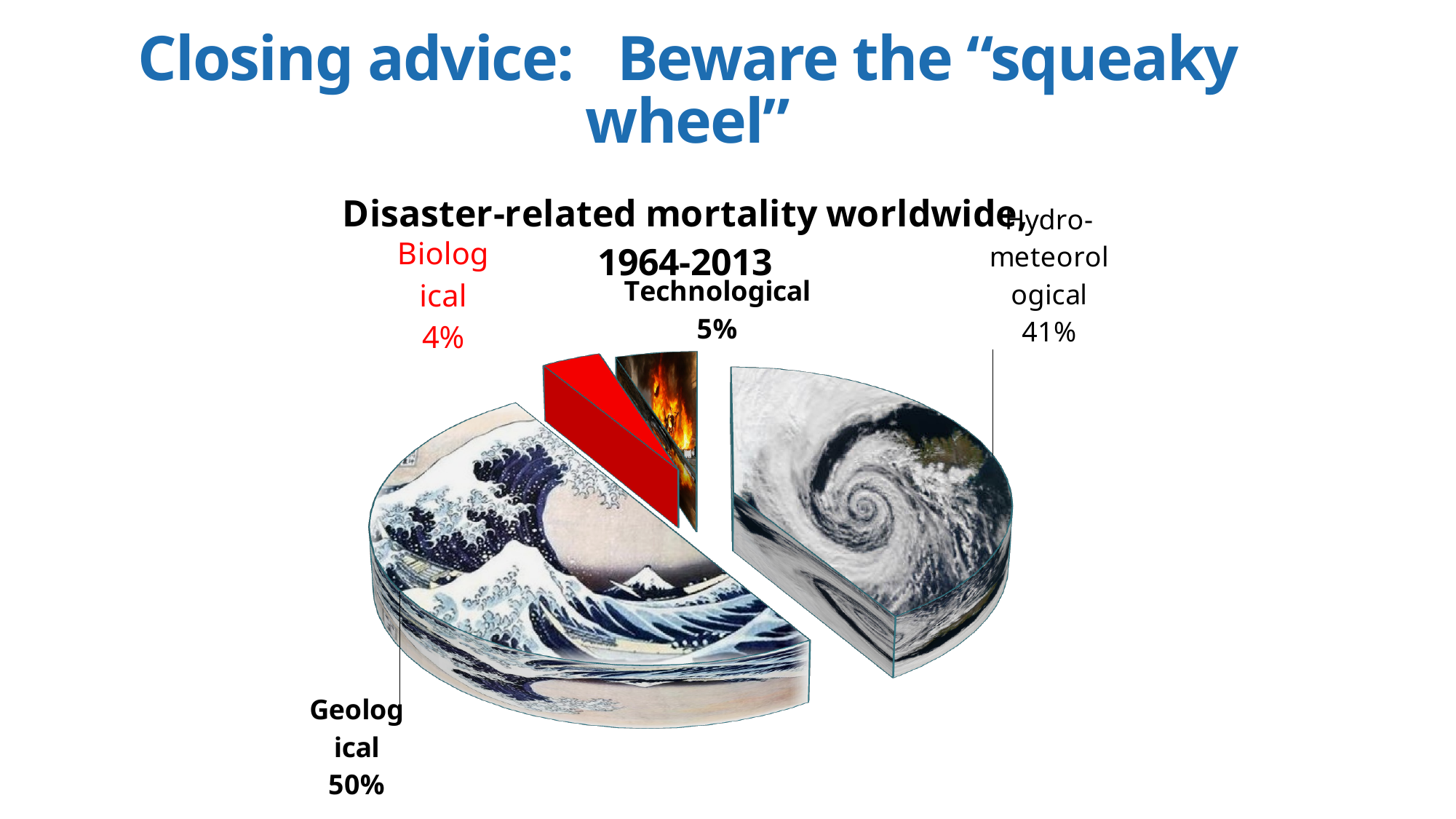
What share of disaster-related mortality is attributed to Hydro-meteorological disasters? 41% What kind of chart is shown on the slide? pie chart What is the combined share of the Biological and Technological slices? 9% What is the title of the chart? Disaster-related mortality worldwide 1964-2013 What is the difference in percentage points between the Geological and Hydro-meteorological shares? 9 How many categories does the pie chart show? 4 What share of disaster-related mortality is attributed to Technological disasters? 5% Which is larger, the Technological share or the Biological share? Technological Which category has the smallest share of disaster-related mortality? Biological What share of disaster-related mortality is attributed to Biological disasters? 4% Which category has the largest share of disaster-related mortality? Geological What share of disaster-related mortality is attributed to Geological disasters? 50%